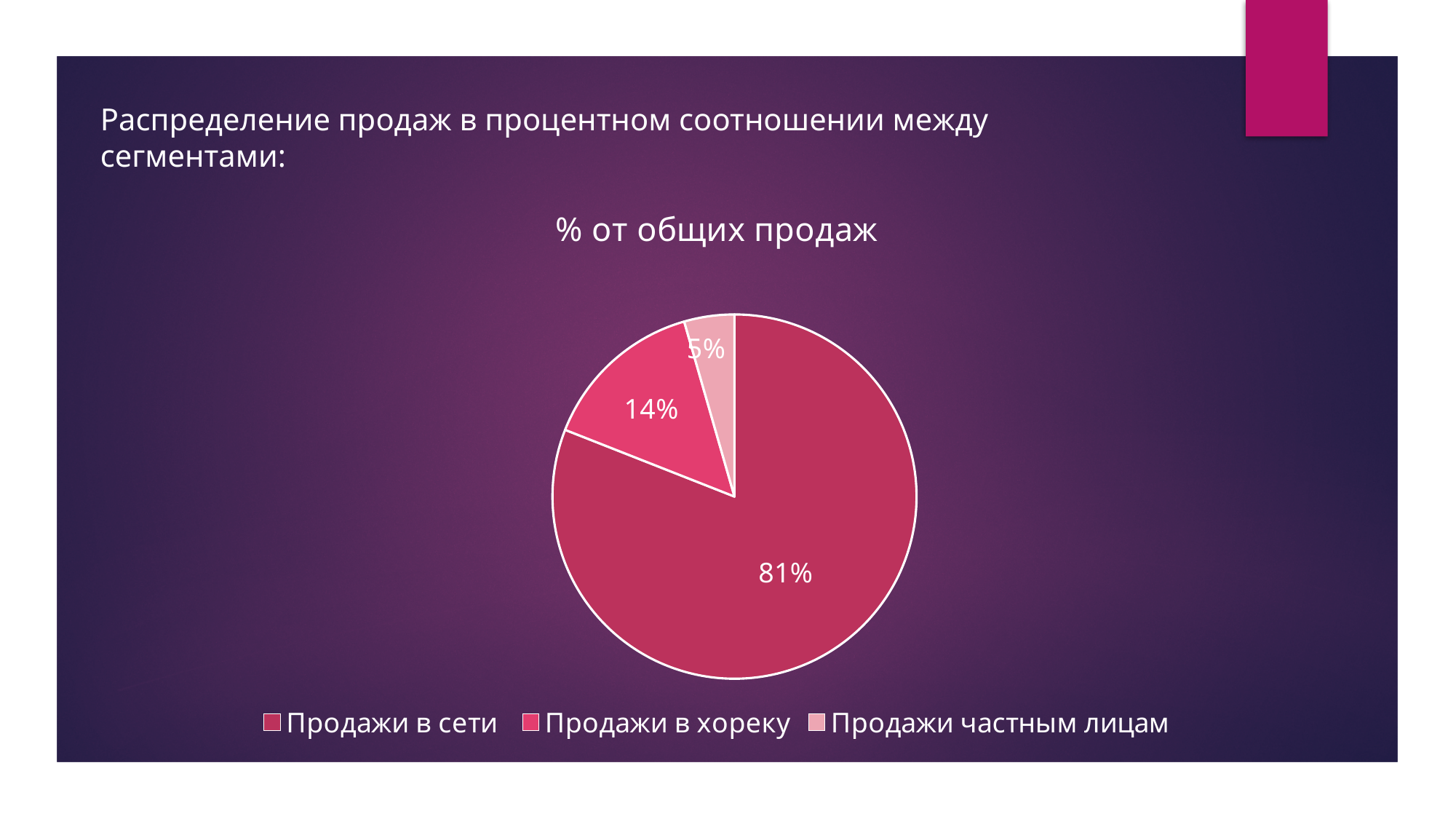
What is the difference in percentage points between Продажи в сети and Продажи в хореку? 67 What share of total sales is attributed to Продажи в хореку? 14% Which segment has the largest share of total sales? Продажи в сети What type of chart is shown on the slide? pie chart What share of total sales is attributed to Продажи частным лицам? 5% What share of total sales is attributed to Продажи в сети? 81% What is the combined share of Продажи в хореку and Продажи частным лицам? 19% How many segments are shown in the pie chart? 3 Which is larger: the share for Продажи в хореку or for Продажи частным лицам? Продажи в хореку What is the title of the chart? % от общих продаж How many entries does the legend list? 3 Which segment has the smallest share of total sales? Продажи частным лицам